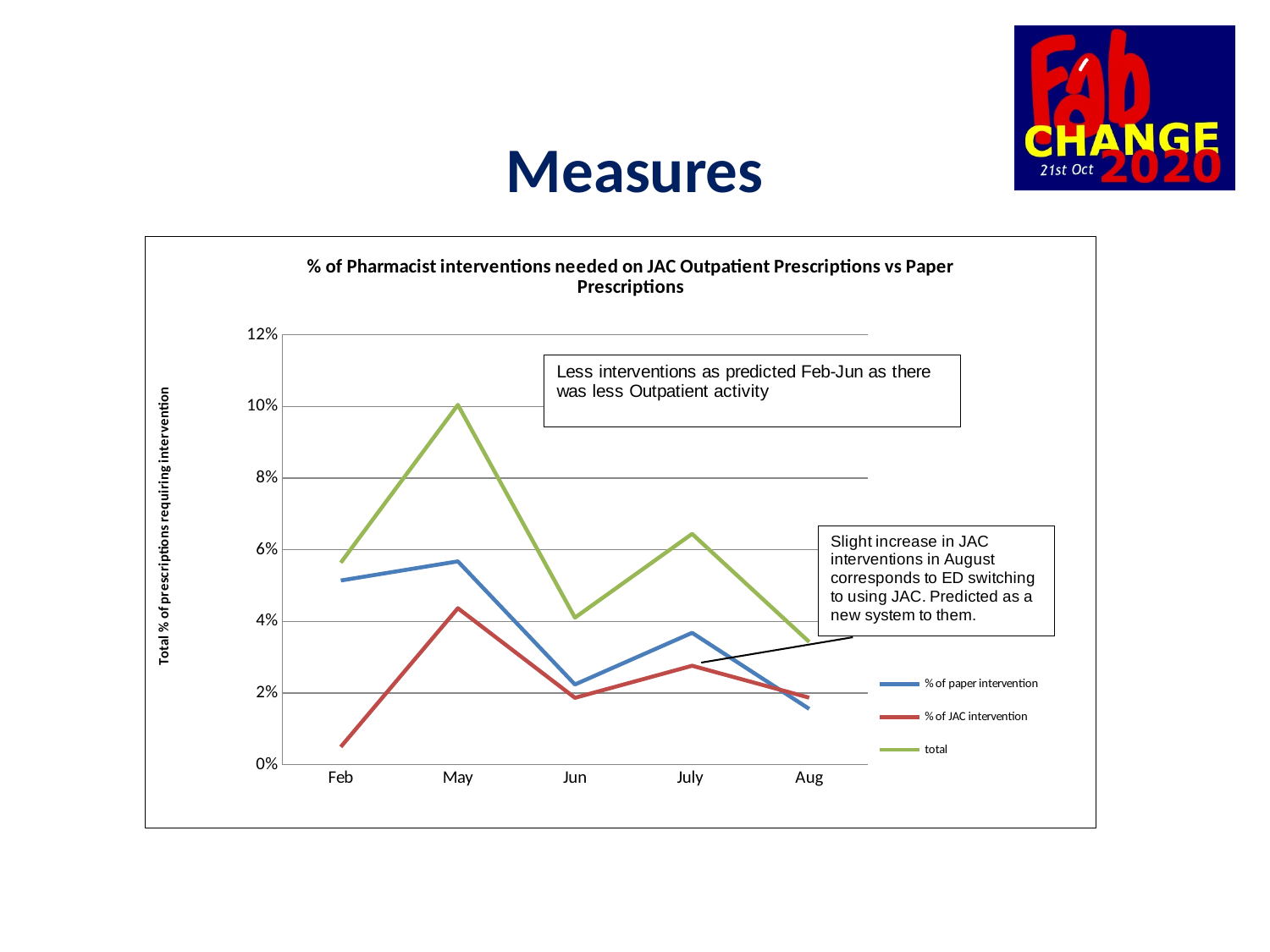
What is the title of the chart's vertical axis? Total % of prescriptions requiring intervention In which month does the total series reach its highest value? May Is the % of paper intervention for Jun greater or less than 4%? less In which month does the % of paper intervention reach its highest value? May In May, which is larger: the % of paper intervention or the % of JAC intervention? % of paper intervention In which month is the % of JAC intervention at its lowest? Feb How many series does the chart legend list? 3 Is the total value for May greater or less than 8%? greater What kind of chart is shown on the slide? line chart How many months are plotted along the x axis? 5 Is the % of JAC intervention for Feb greater or less than 2%? less Does the total series rise or fall from May to Jun? fall